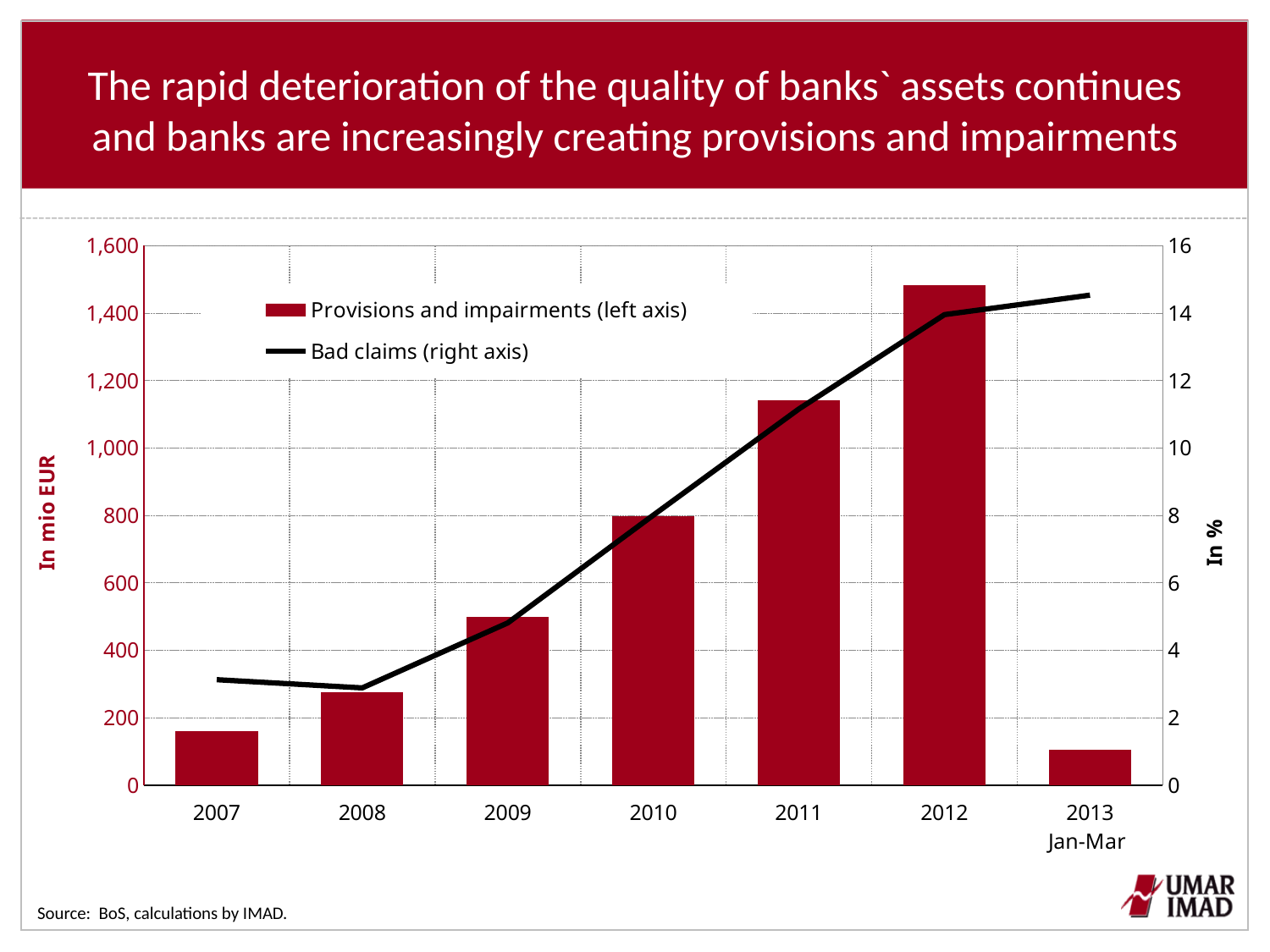
Is the Provisions and impairments bar for 2008 greater or less than 400? less Which is larger, the Provisions and impairments bar for 2010 or for 2009? 2010 What is the unit label on the right axis? In % Which is larger, the Bad claims value for 2011 or for 2008? 2011 Is the Provisions and impairments bar for 2011 greater or less than 1,000? greater How many categories are shown on the x axis? 7 Which category has the lowest bar for Provisions and impairments? 2013 Jan-Mar Is the Bad claims value for 2012 greater or less than 12? greater Which year has the highest bar for Provisions and impairments? 2012 How many series does the legend list? 2 What kind of chart is used for the Provisions and impairments series? Bar chart